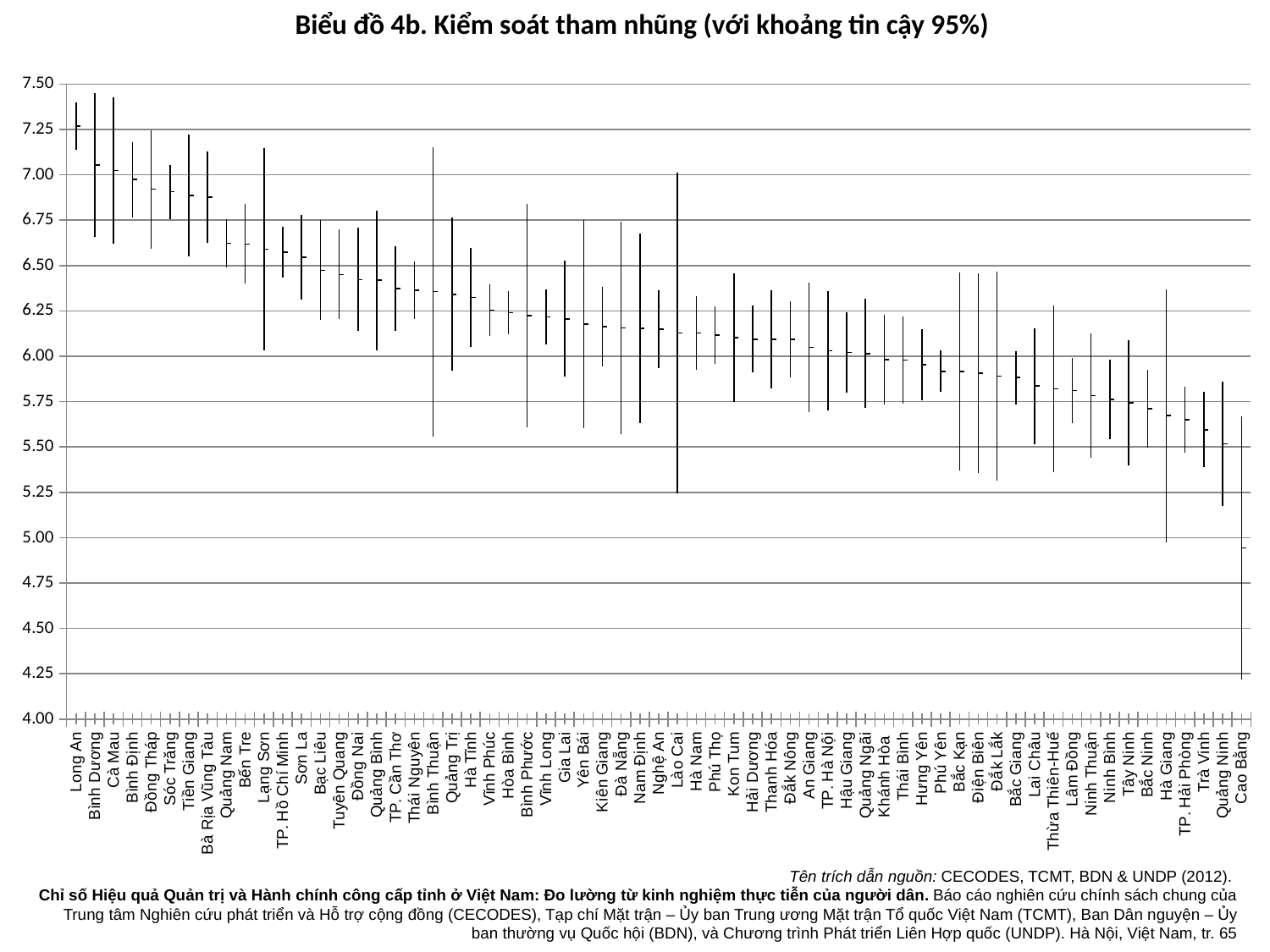
What is the range of the y axis in the chart? 4.00 to 7.50 Which province has the lowest point estimate in the chart? Cao Bằng Do the point estimates rise or fall moving from left to right along the x axis? fall Is the point estimate for Long An greater or less than 7.00? greater Which province has the highest point estimate in the chart? Long An What is the title of the chart? Biểu đồ 4b. Kiểm soát tham nhũng (với khoảng tin cậy 95%) Is the point estimate for Hà Giang greater or less than 6.00? less Which province has the widest confidence interval in the chart? Lào Cai Is the lower end of the confidence interval for Cao Bằng greater or less than 4.50? less Which province has the larger point estimate, Bến Tre or Bắc Kạn? Bến Tre How many provinces are shown on the x axis of the chart? 63